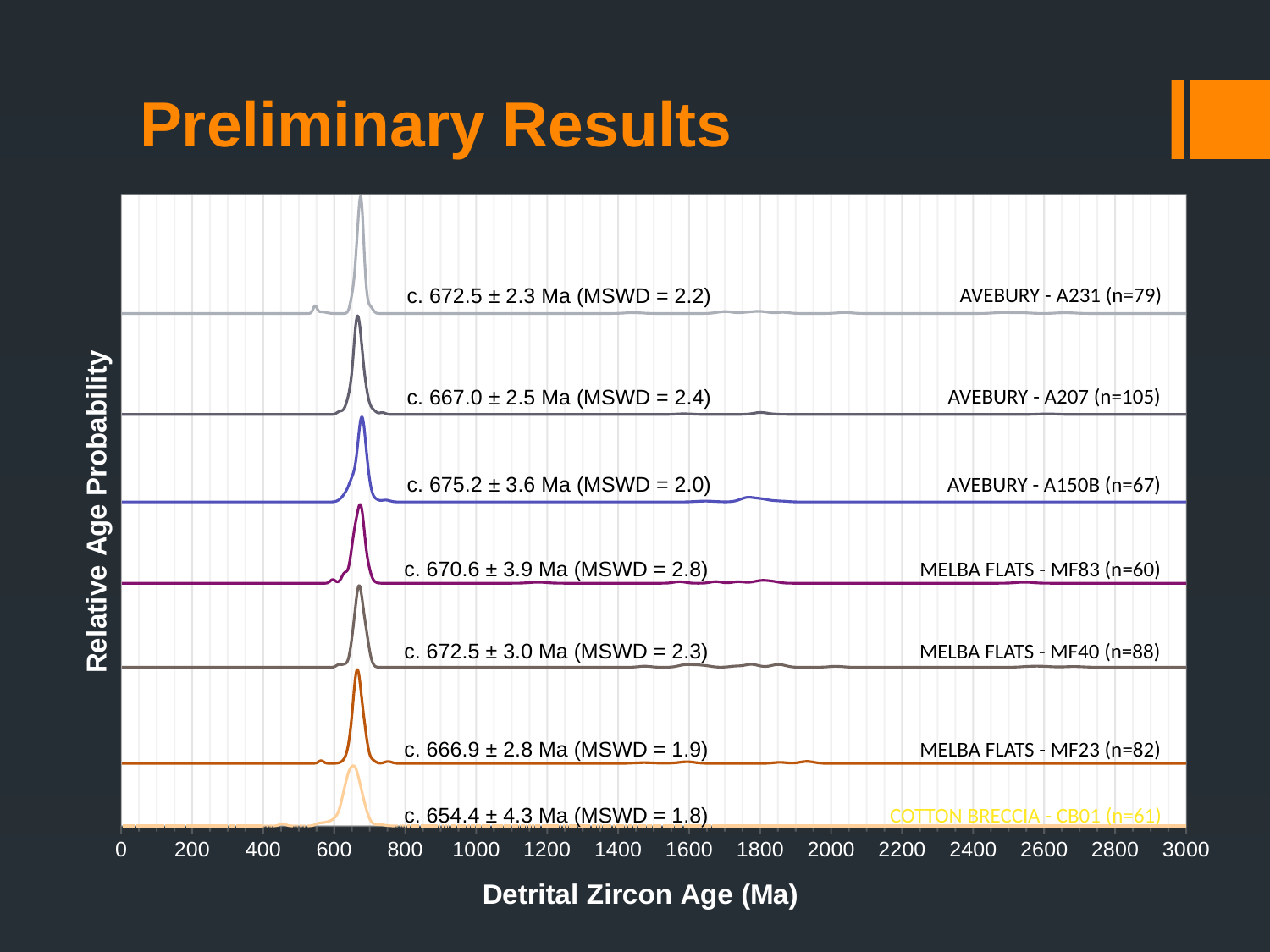
Which sample has the largest number of grains (n)? AVEBURY - A207 How many samples (curves) are plotted on the chart? 7 Which sample has the larger n, MELBA FLATS - MF40 or MELBA FLATS - MF23? MELBA FLATS - MF40 What is the MSWD value printed for the COTTON BRECCIA - CB01 sample? 1.8 What kind of chart is shown on the slide? Line chart How many grains (n) are reported for the AVEBURY - A207 sample? 105 Is the main peak of the AVEBURY - A150B curve at an age greater or less than 1000 Ma? less What is the difference in n between AVEBURY - A207 and COTTON BRECCIA - CB01? 44 What is the age reported for the AVEBURY - A231 sample? c. 672.5 ± 2.3 Ma What is the age reported for the MELBA FLATS - MF23 sample? c. 666.9 ± 2.8 Ma What is the title of the x axis? Detrital Zircon Age (Ma) Which sample has the smallest number of grains (n)? MELBA FLATS - MF83